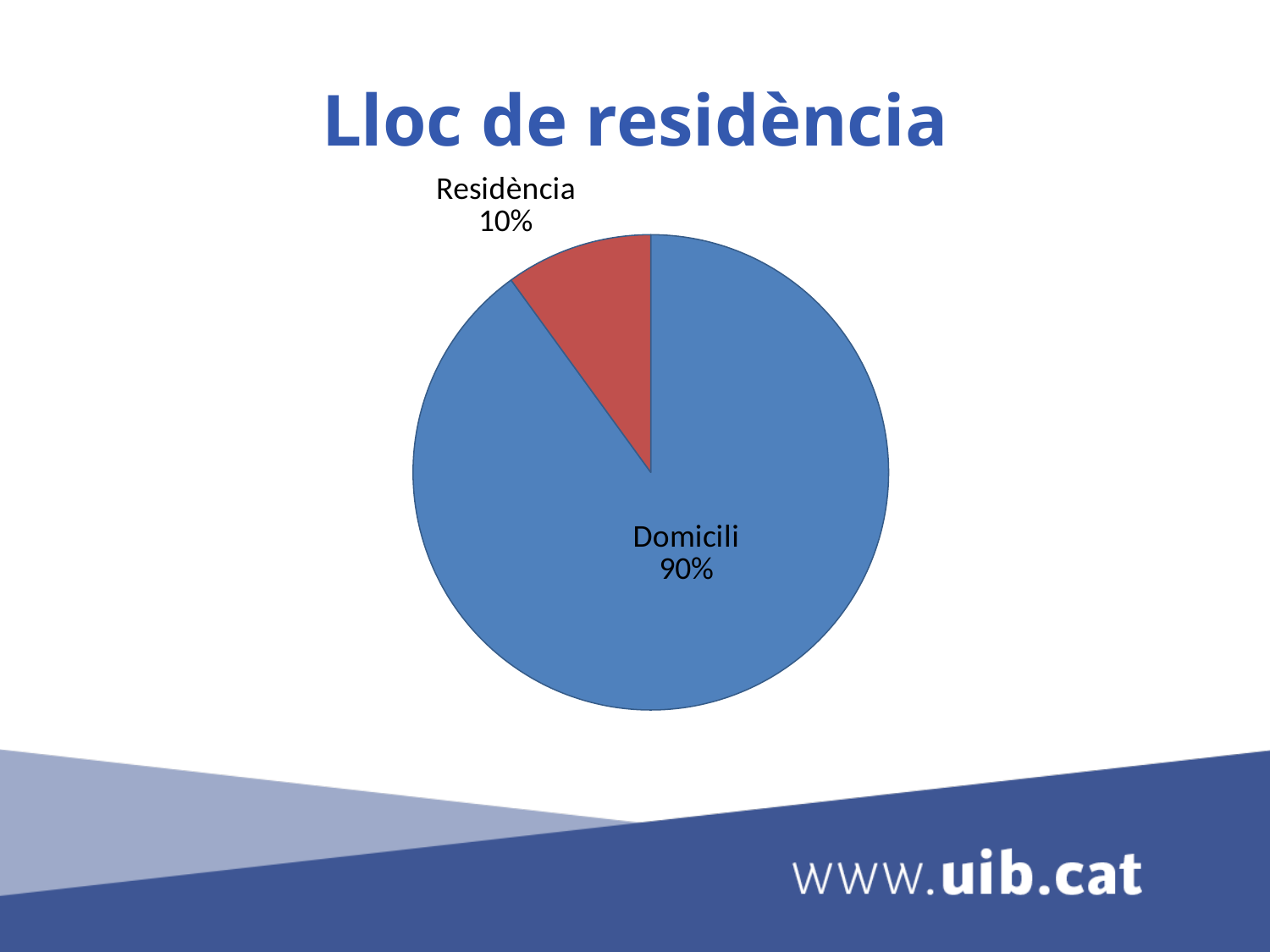
What is the difference in percentage points between Domicili and Residència? 80 Which category has the largest share of the pie? Domicili What is the title of the chart? Lloc de residència What kind of chart is shown on the slide? pie chart What percentage is shown for Residència? 10% What colour is the Residència slice? red What share of the pie does the Domicili slice represent? 90% How many slices does the pie chart have? 2 Which is larger, the share for Domicili or the share for Residència? Domicili Which category has the smallest share of the pie? Residència What percentage is shown for Domicili? 90%